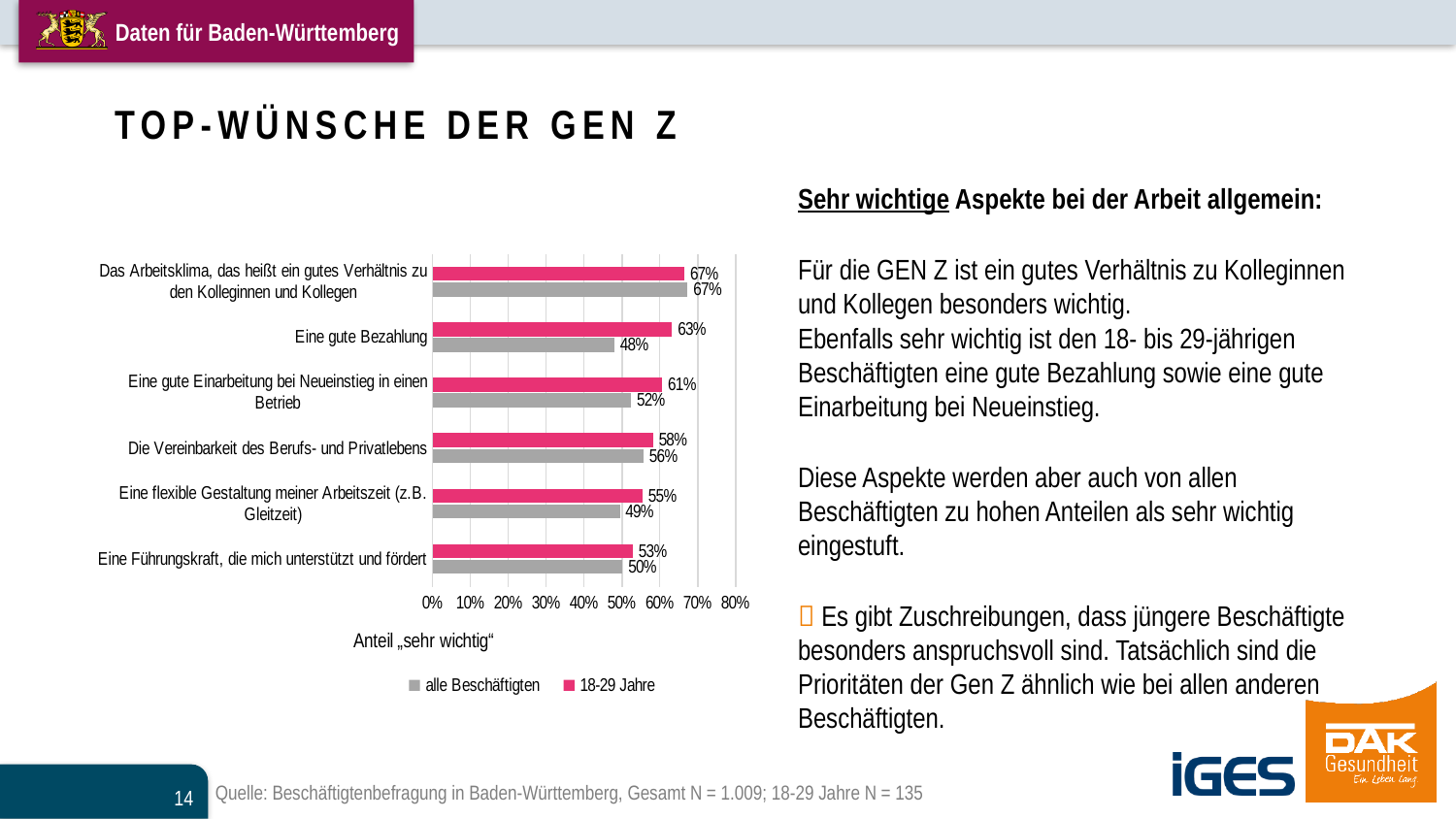
What is the difference between the "18-29 Jahre" and "alle Beschäftigten" values for "Eine gute Bezahlung"? 15% How many series does the chart legend list? 2 Which category has the lowest value in the "alle Beschäftigten" series? Eine gute Bezahlung What kind of chart is shown on the slide? bar chart What is the difference between the "18-29 Jahre" and "alle Beschäftigten" values for "Eine flexible Gestaltung meiner Arbeitszeit (z.B. Gleitzeit)"? 6% Which colour represents the "18-29 Jahre" series in the chart? pink/red For "Eine gute Einarbeitung bei Neueinstieg in einen Betrieb", which series has the larger value, "18-29 Jahre" or "alle Beschäftigten"? 18-29 Jahre What is the value for "Die Vereinbarkeit des Berufs- und Privatlebens" in the "alle Beschäftigten" series? 56% What is the value for "Eine gute Bezahlung" in the "18-29 Jahre" series? 63% What is the value for "Eine gute Bezahlung" in the "alle Beschäftigten" series? 48% Which category has the highest value in the "18-29 Jahre" series? Das Arbeitsklima, das heißt ein gutes Verhältnis zu den Kolleginnen und Kollegen How many categories (aspects) are shown in the chart? 6